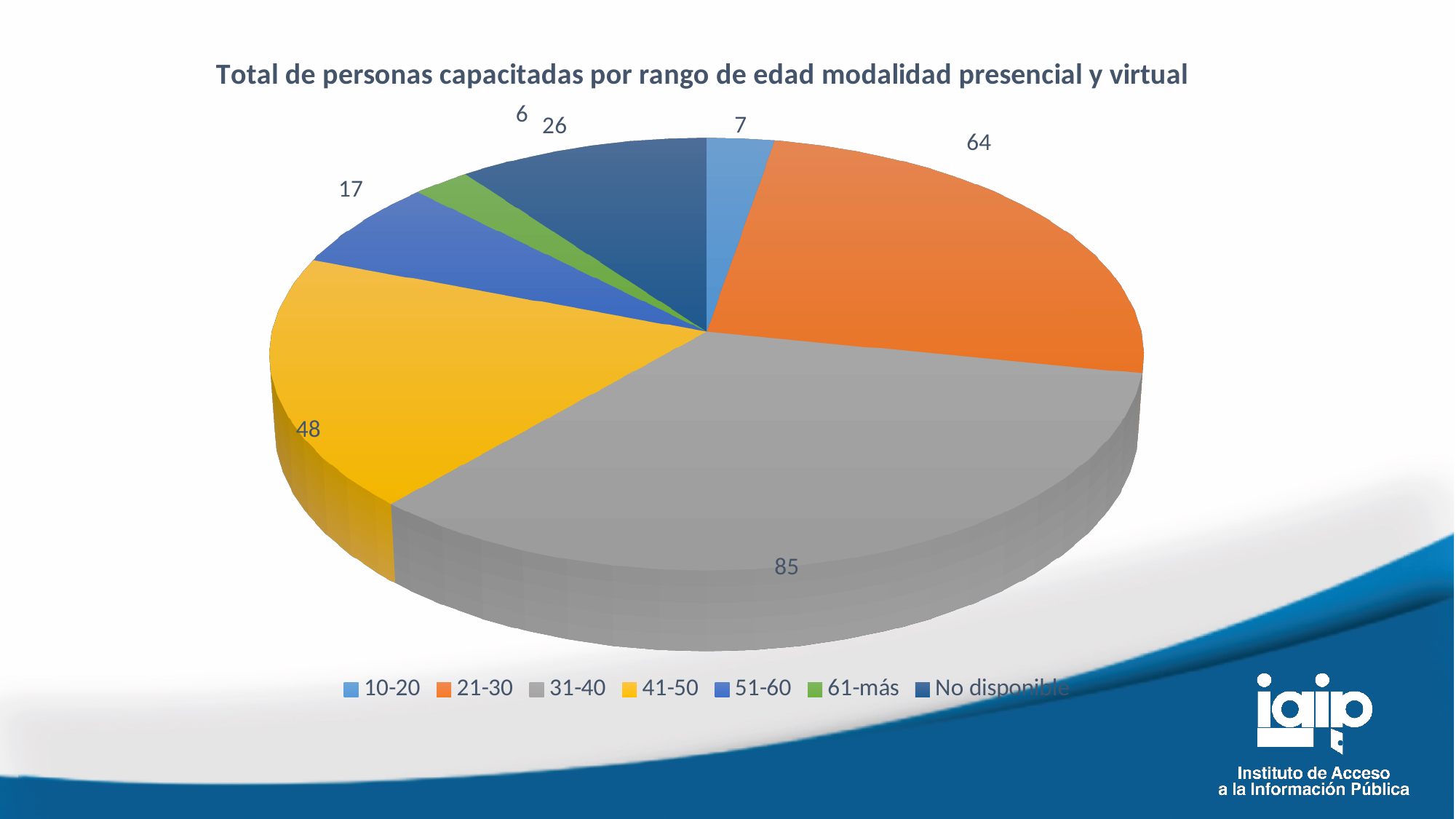
What is the value for the 31-40 age range? 85 What is the value for the 51-60 age range? 17 Which is larger, the value for 10-20 or the value for 51-60? 51-60 Which age range has the largest number of people trained? 31-40 What is the total of all the values shown in the pie chart? 253 What is the value for the 21-30 age range? 64 What is the difference between the values for 31-40 and 41-50? 37 What is the title of the chart? Total de personas capacitadas por rango de edad modalidad presencial y virtual How many categories does the pie chart have? 7 What kind of chart is shown on the slide? Pie chart What is the value for the 'No disponible' category? 26 Which category has the smallest value in the pie chart? 61-más